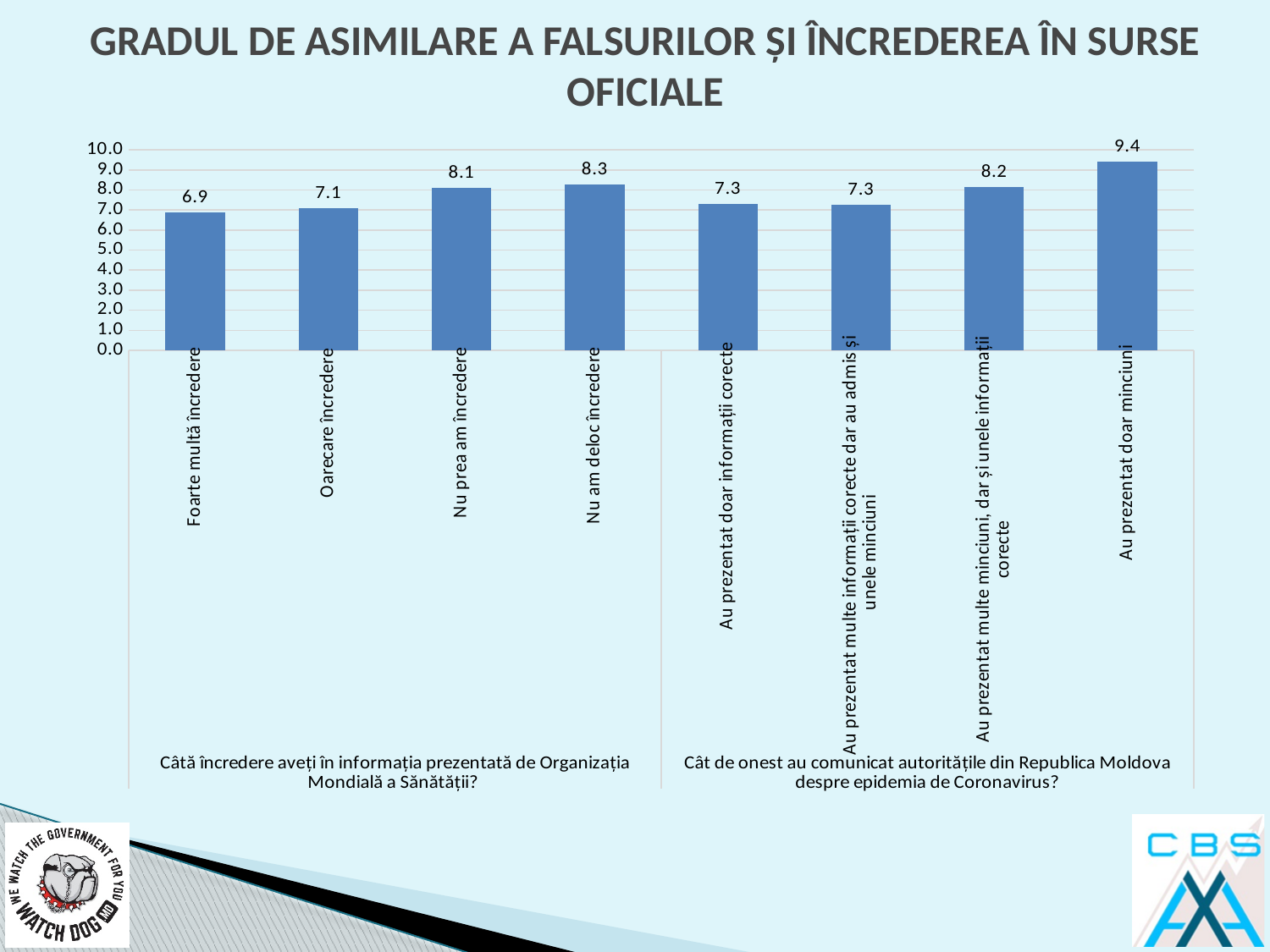
How many bars are plotted on the chart? 8 What is the value for "Au prezentat doar minciuni"? 9.4 Which category has the highest value? Au prezentat doar minciuni What is the difference between the values for "Au prezentat doar minciuni" and "Foarte multă încredere"? 2.5 What kind of chart is shown on the slide? Bar chart Which category has the lowest value? Foarte multă încredere What is the value for "Au prezentat multe minciuni, dar și unele informații corecte"? 8.2 What is the title of the chart? GRADUL DE ASIMILARE A FALSURILOR ȘI ÎNCREDEREA ÎN SURSE OFICIALE What is the value for "Nu am deloc încredere"? 8.3 What is the difference between the values for "Nu am deloc încredere" and "Oarecare încredere"? 1.2 Which is larger, the value for "Nu prea am încredere" or the value for "Au prezentat doar informații corecte"? Nu prea am încredere What is the value for "Foarte multă încredere"? 6.9